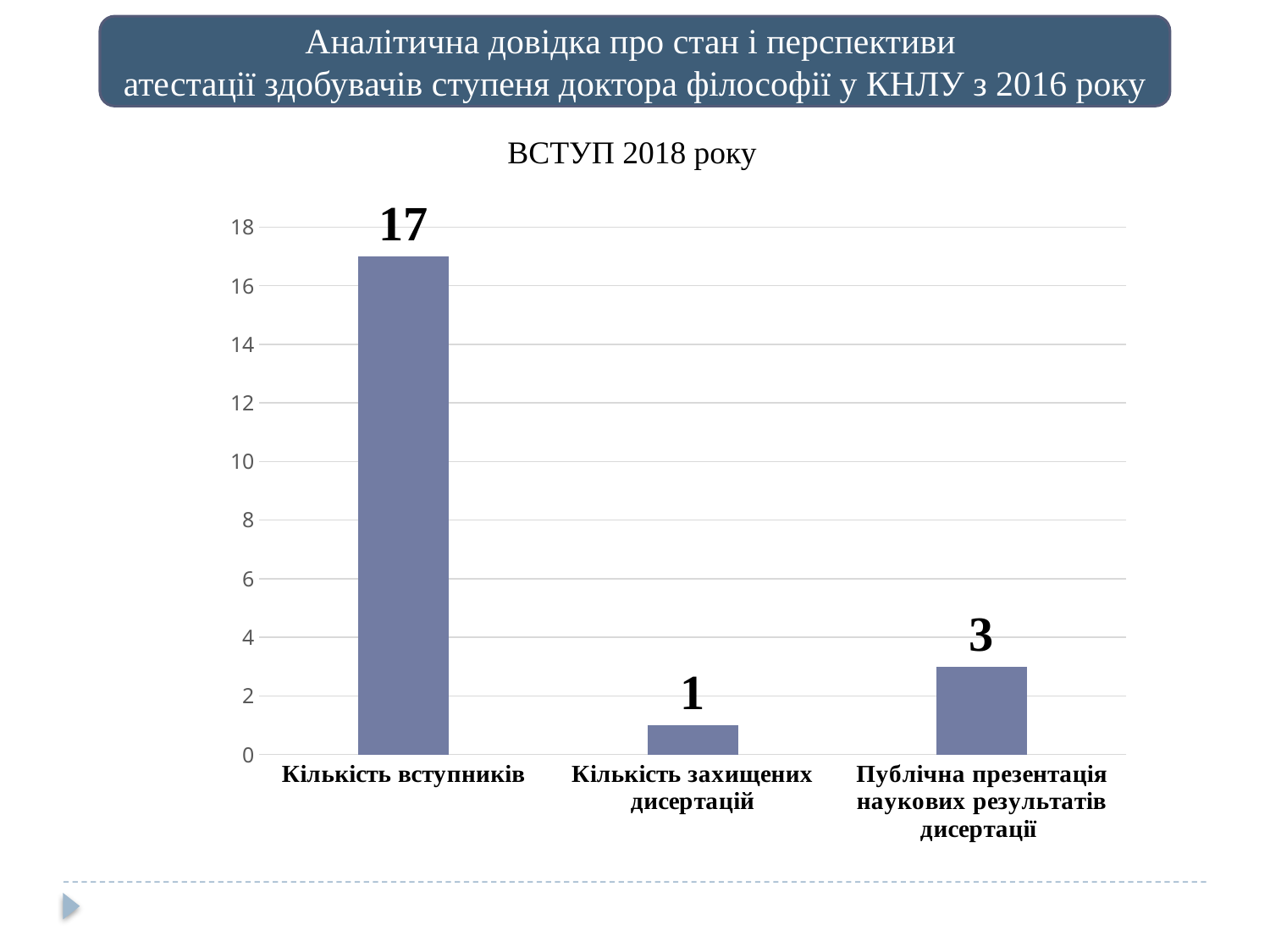
Which category has the highest value? Кількість вступників Which is larger: the value for Кількість захищених дисертацій or the value for Публічна презентація наукових результатів дисертації? Публічна презентація наукових результатів дисертації How many categories are shown in the chart? 3 What is the value for Публічна презентація наукових результатів дисертації? 3 Is the value for Кількість вступників greater or less than 10? greater What is the title of the chart? ВСТУП 2018 року What is the difference between the values for Публічна презентація наукових результатів дисертації and Кількість захищених дисертацій? 2 What is the difference between the values for Кількість вступників and Публічна презентація наукових результатів дисертації? 14 What is the value for Кількість вступників? 17 Which category has the lowest value? Кількість захищених дисертацій What is the value for Кількість захищених дисертацій? 1 What kind of chart is shown on the slide? bar chart